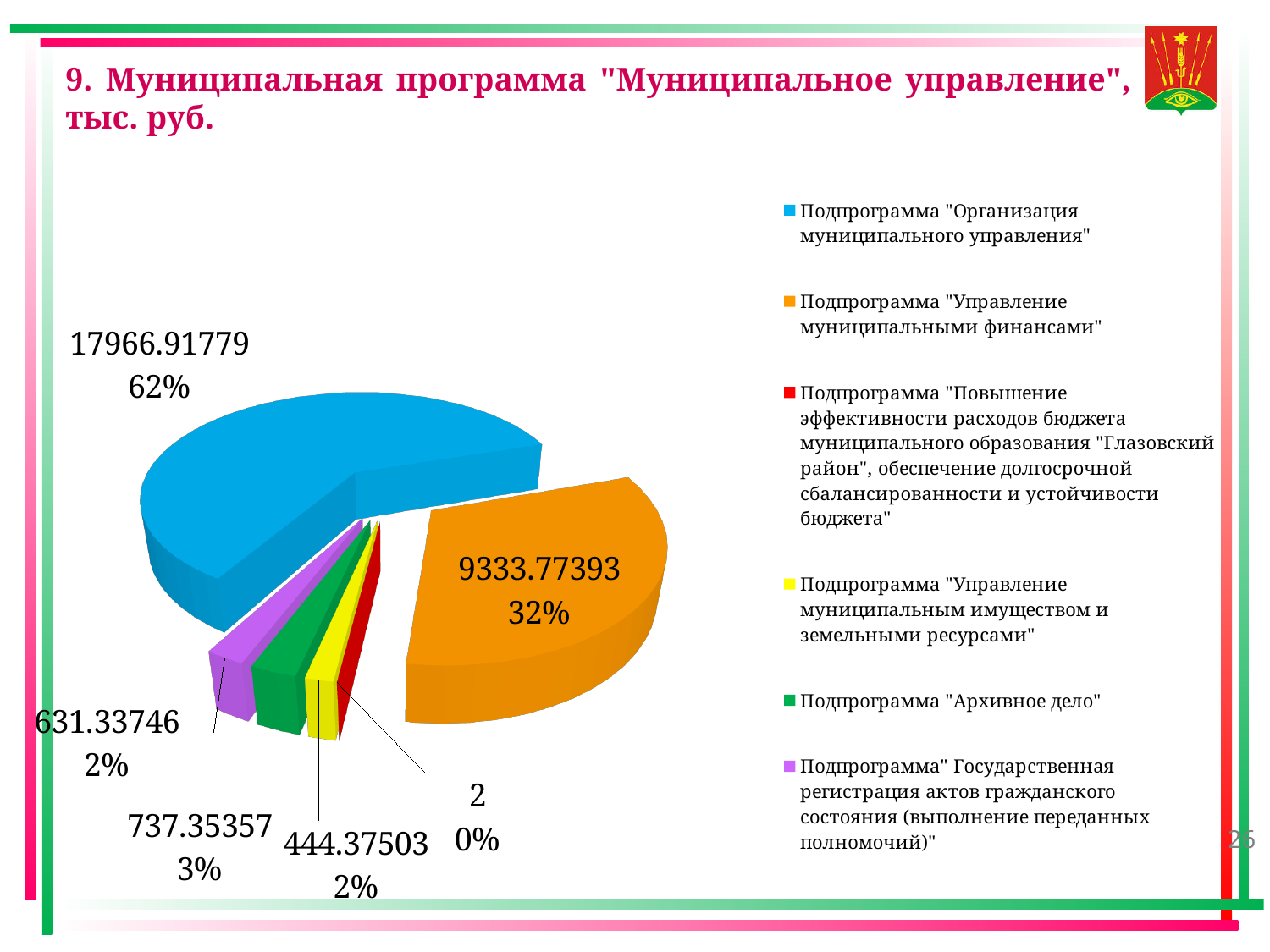
Which subprogram has the smallest slice of the pie? Подпрограмма "Повышение эффективности расходов бюджета муниципального образования "Глазовский район", обеспечение долгосрочной сбалансированности и устойчивости бюджета" What is the value for the subprogram "Организация муниципального управления"? 17966.91779 What share of the pie does the subprogram "Организация муниципального управления" take? 62% How many entries does the legend list? 6 What is the value for the subprogram "Управление муниципальными финансами"? 9333.77393 What share of the pie does the subprogram "Управление муниципальными финансами" take? 32% Which is larger: the value for "Архивное дело" or the value for "Государственная регистрация актов гражданского состояния"? Подпрограмма "Архивное дело" Which subprogram has the largest slice of the pie? Подпрограмма "Организация муниципального управления" What is the value for the subprogram "Архивное дело"? 737.35357 What kind of chart is shown on the slide? pie chart How many slices does the pie chart have? 6 What is the value for the subprogram "Управление муниципальным имуществом и земельными ресурсами"? 444.37503